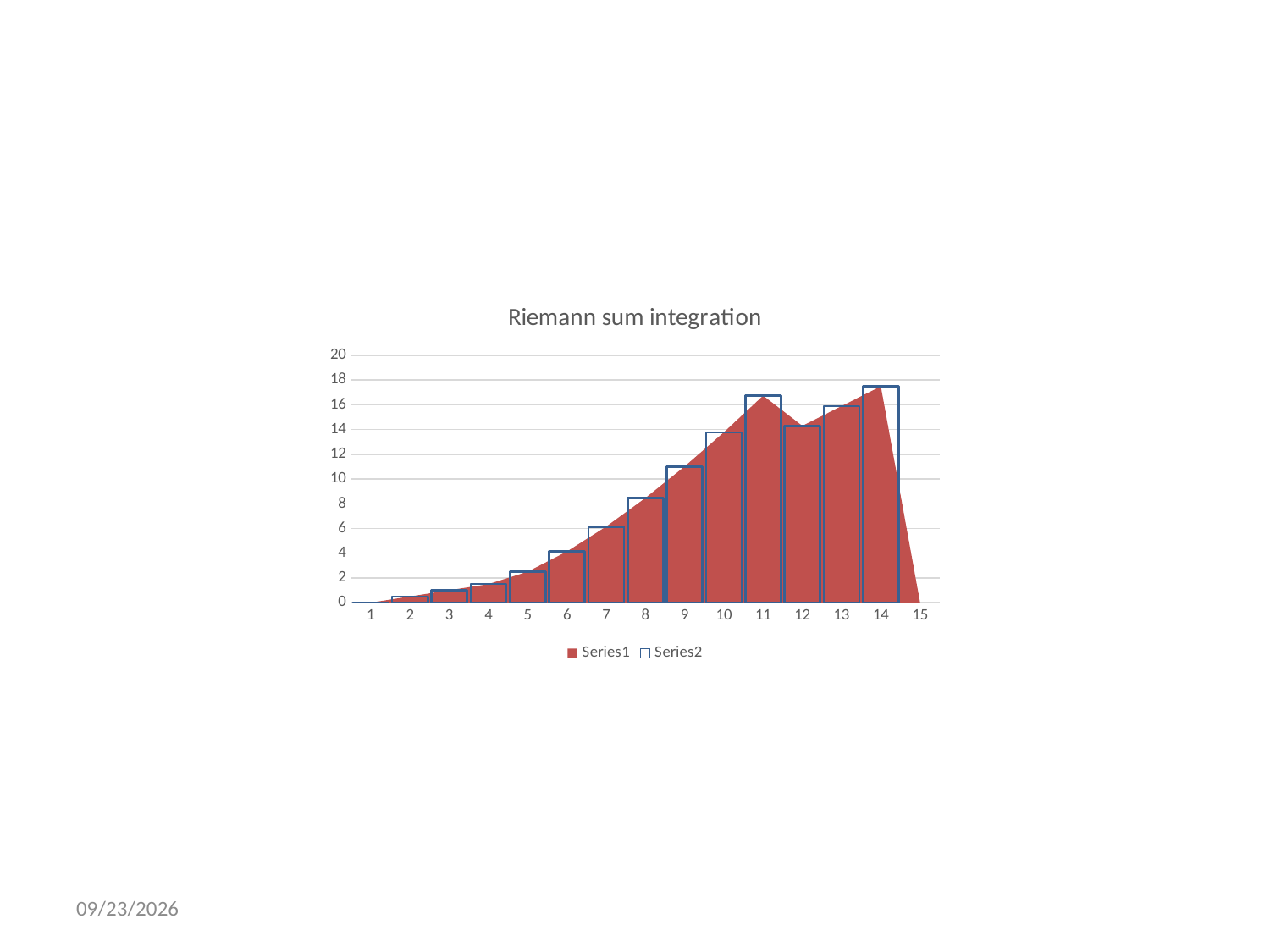
How many series does the legend list? 2 Is the Series2 bar at category 11 greater or less than 14? greater Is the Series2 bar at category 12 greater or less than 16? less What colour is the Series1 area? red Does Series1 rise or fall between categories 1 and 11? rise At which x-axis category is the Series2 bar highest? 14 What is the title of the chart? Riemann sum integration Is the Series2 bar at category 5 greater or less than 4? less What kind of chart is Series2 drawn as? bar chart How many categories are shown on the x axis? 15 What kind of chart is Series1 drawn as? area chart Which Series2 bar is taller, the one at category 11 or the one at category 12? 11